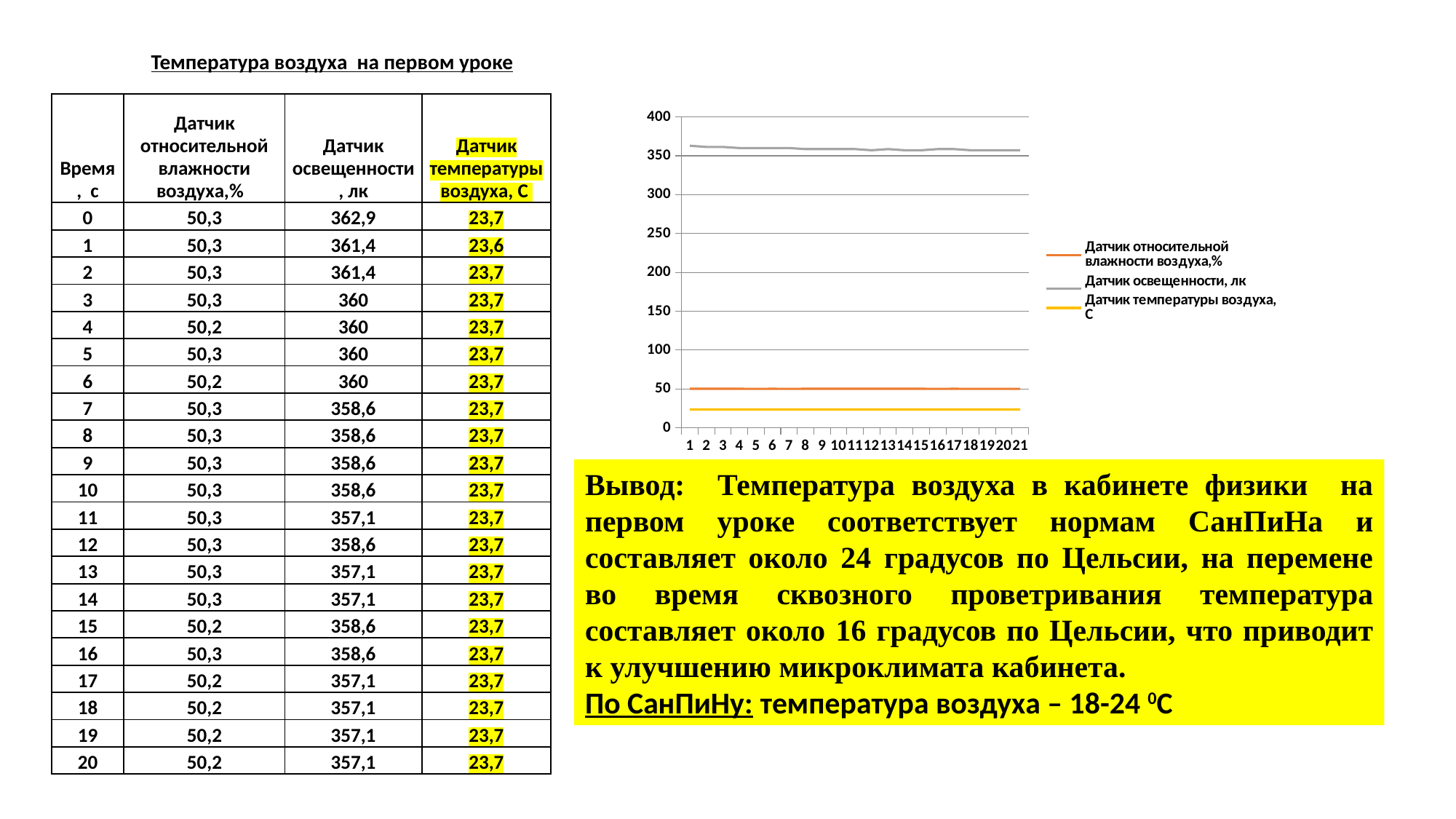
What is the highest value shown on the chart's y axis? 400 Is the value of the Датчик освещенности, лк series at point 1 greater or less than 300? greater Is the value of the Датчик относительной влажности воздуха,% series at point 10 greater or less than 100? less What kind of chart is shown on the slide? line chart Which series in the chart has the lowest values? Датчик температуры воздуха, С How many series does the chart legend list? 3 Which series in the chart has the highest values? Датчик освещенности, лк Which is larger at point 15: the Датчик относительной влажности воздуха,% series or the Датчик температуры воздуха, С series? Датчик относительной влажности воздуха,% Is the value of the Датчик температуры воздуха, С series at point 5 greater or less than 50? less Does the Датчик освещенности, лк series rise, fall, or stay roughly flat across the x axis? roughly flat How many points are plotted along the x axis of the chart? 21 What colour is the line for the Датчик температуры воздуха, С series in the chart? yellow